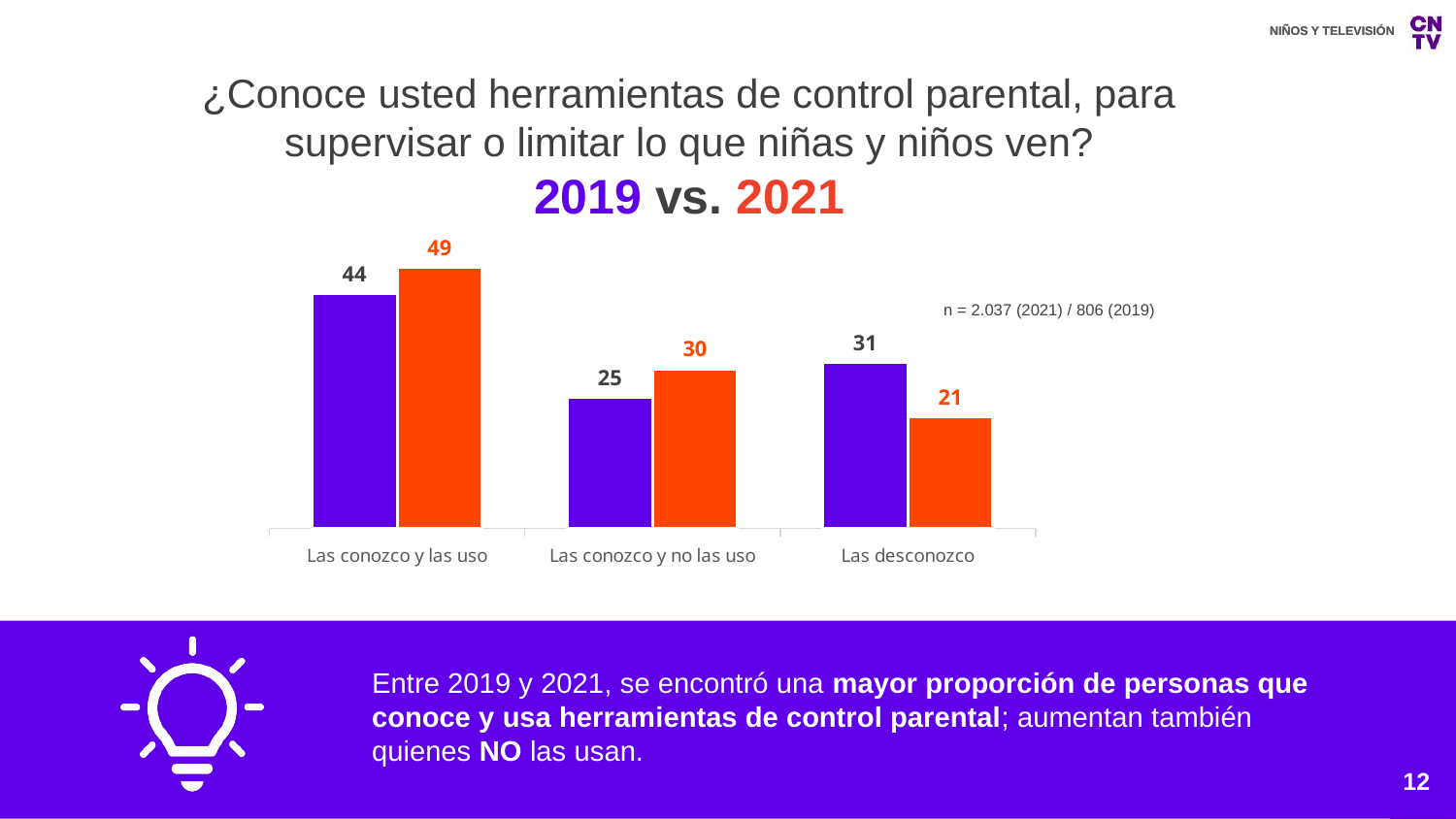
Which category has the highest 2021 value? Las conozco y las uso For 'Las conozco y no las uso', which year has the larger value, 2019 or 2021? 2021 How many series (years) does the chart compare? 2 What kind of chart is shown on the slide? Bar chart How many categories are shown on the x axis? 3 What is the 2019 value for 'Las conozco y no las uso'? 25 For 'Las desconozco', which year has the larger value, 2019 or 2021? 2019 Which category has the lowest 2019 value? Las conozco y no las uso What is the 2021 value for 'Las conozco y las uso'? 49 What is the difference between the 2021 and 2019 values for 'Las desconozco'? 10 What is the difference between the 2021 and 2019 values for 'Las conozco y las uso'? 5 What is the 2019 value for 'Las desconozco'? 31